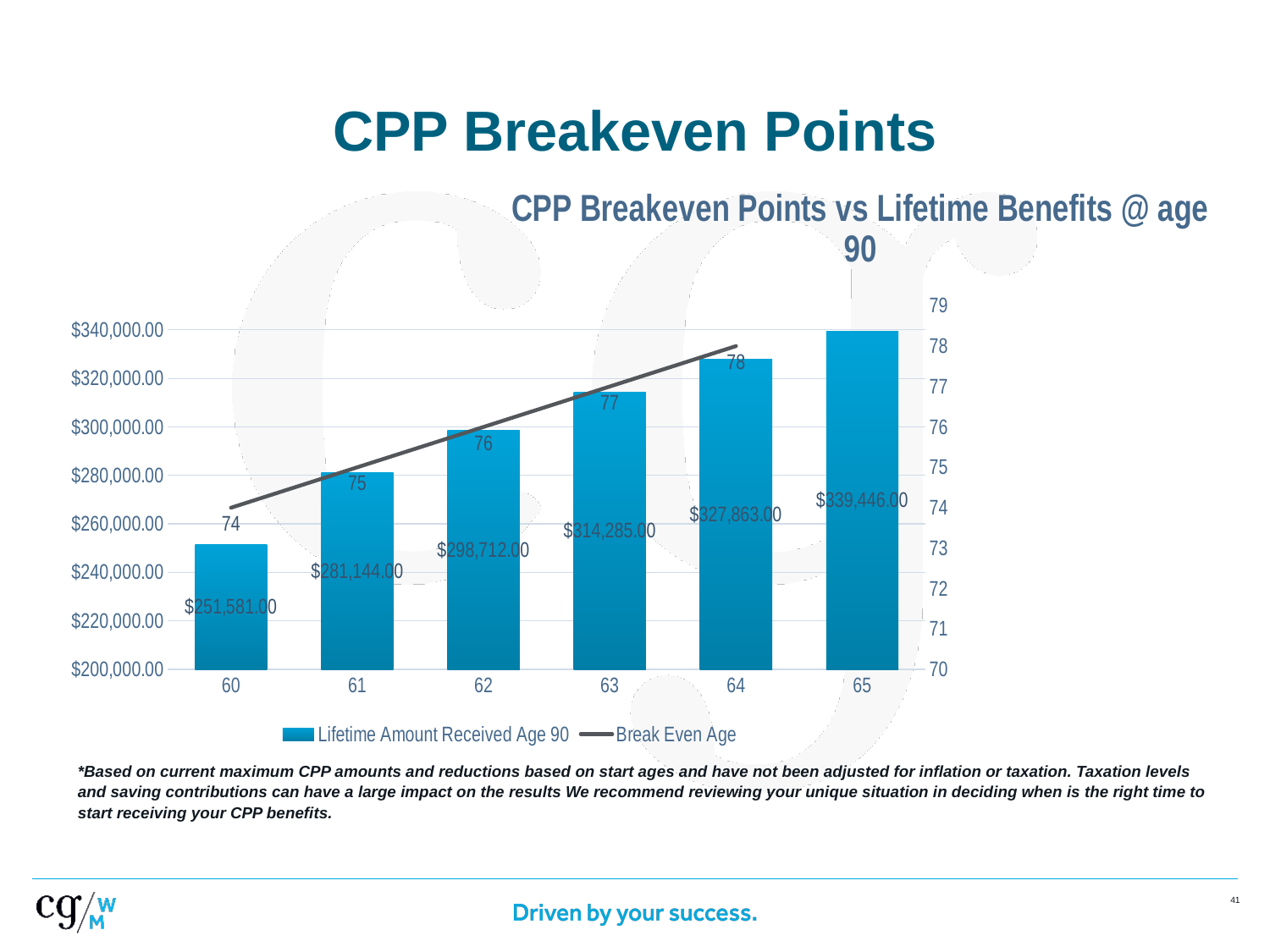
What kind of chart is shown on the slide? bar chart with a line What is the Break Even Age for a start age of 62? 76 Do the Lifetime Amount Received Age 90 values rise or fall as the start age increases from 60 to 65? rise Which start age has the highest Lifetime Amount Received Age 90? 65 What is the Lifetime Amount Received Age 90 for a start age of 60? $251,581.00 Which is larger, the Lifetime Amount Received Age 90 at start age 61 or at start age 64? 64 How many start ages are shown on the x axis? 6 How many series does the legend list? 2 What is the Lifetime Amount Received Age 90 for a start age of 63? $314,285.00 What is the difference between the Break Even Age at start age 64 and at start age 60? 4 What is the difference between the Lifetime Amount Received Age 90 at start age 65 and at start age 60? $87,865.00 Which start age has the lowest Lifetime Amount Received Age 90? 60